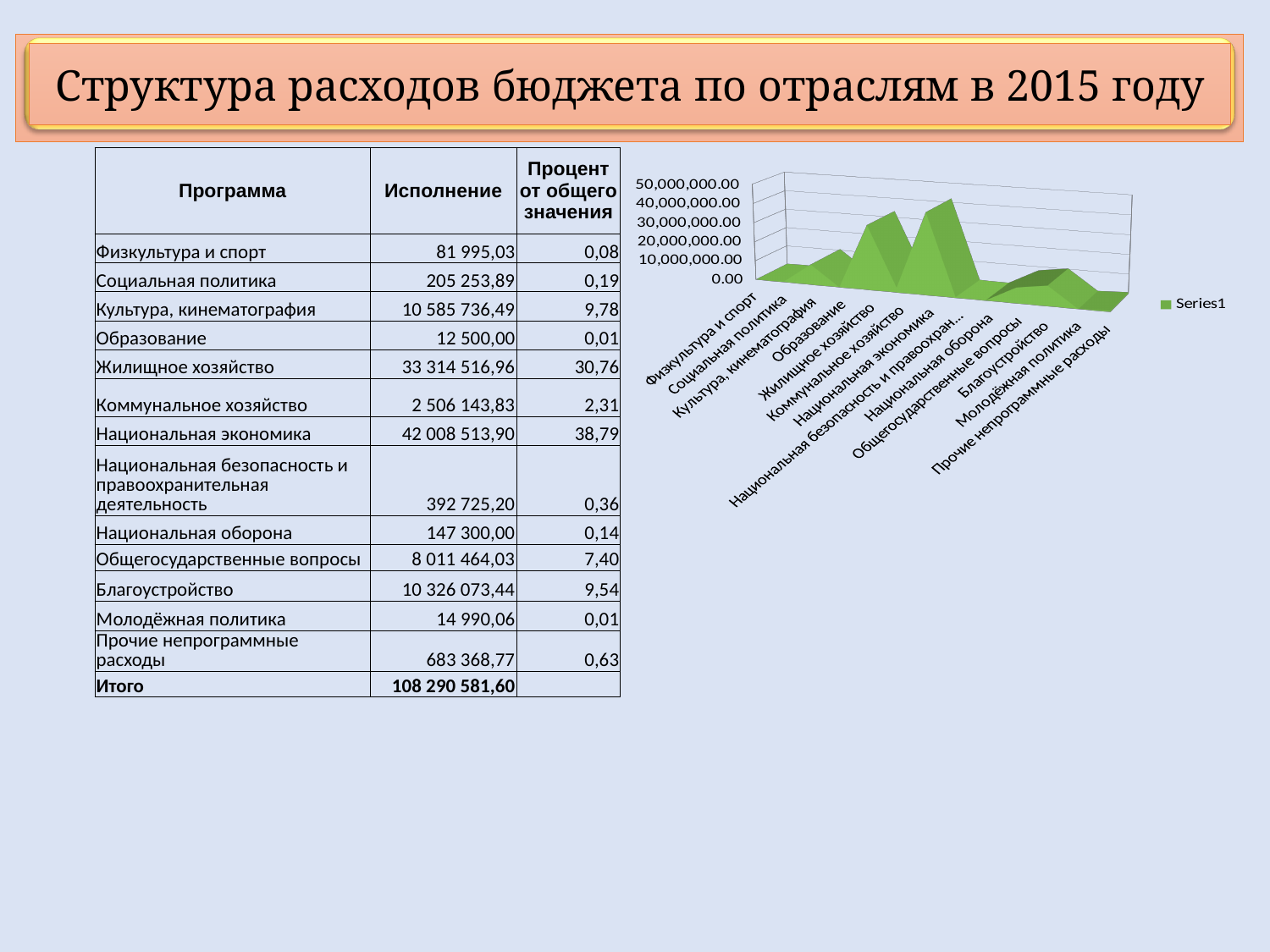
How many series does the chart legend list? 1 In the chart, which is larger: the value for Жилищное хозяйство or the value for Национальная экономика? Национальная экономика Is the value for Физкультура и спорт in the chart greater or less than 10,000,000.00? less What kind of chart is shown on the slide? area chart Is the value for Благоустройство in the chart greater or less than 20,000,000.00? less How many categories are plotted along the x axis of the chart? 13 What is the name of the series shown in the chart legend? Series1 Is the value for Жилищное хозяйство in the chart greater or less than 20,000,000.00? greater Which category has the highest value in the chart? Национальная экономика In the chart, which is larger: the value for Общегосударственные вопросы or the value for Жилищное хозяйство? Жилищное хозяйство What is the highest tick value shown on the chart's vertical axis? 50,000,000.00